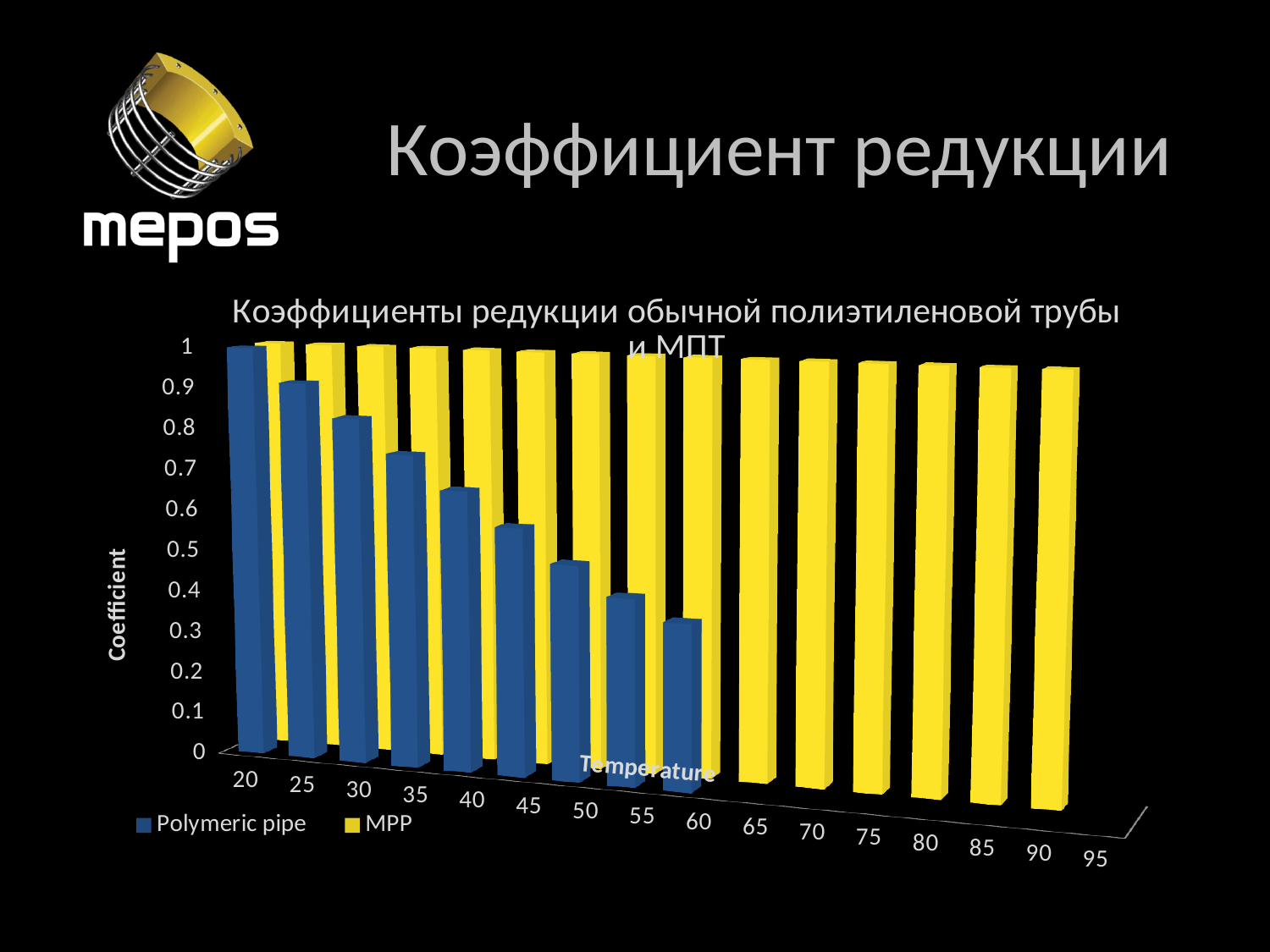
Do the Polymeric pipe values rise or fall as temperature increases? Fall Is the Polymeric pipe coefficient at temperature 60 greater or less than 0.5? less How many temperature categories are shown on the x axis? 16 How many series does the legend list? 2 At which temperature is the Polymeric pipe coefficient highest? 20 At which temperature is the Polymeric pipe coefficient lowest? 60 What are the two series names listed in the legend? Polymeric pipe and MPP At temperature 60, which series has the larger coefficient, Polymeric pipe or MPP? MPP What kind of chart is shown on the slide? Bar chart Is the Polymeric pipe coefficient at temperature 30 greater or less than 0.7? greater How many bars are plotted for the Polymeric pipe series? 9